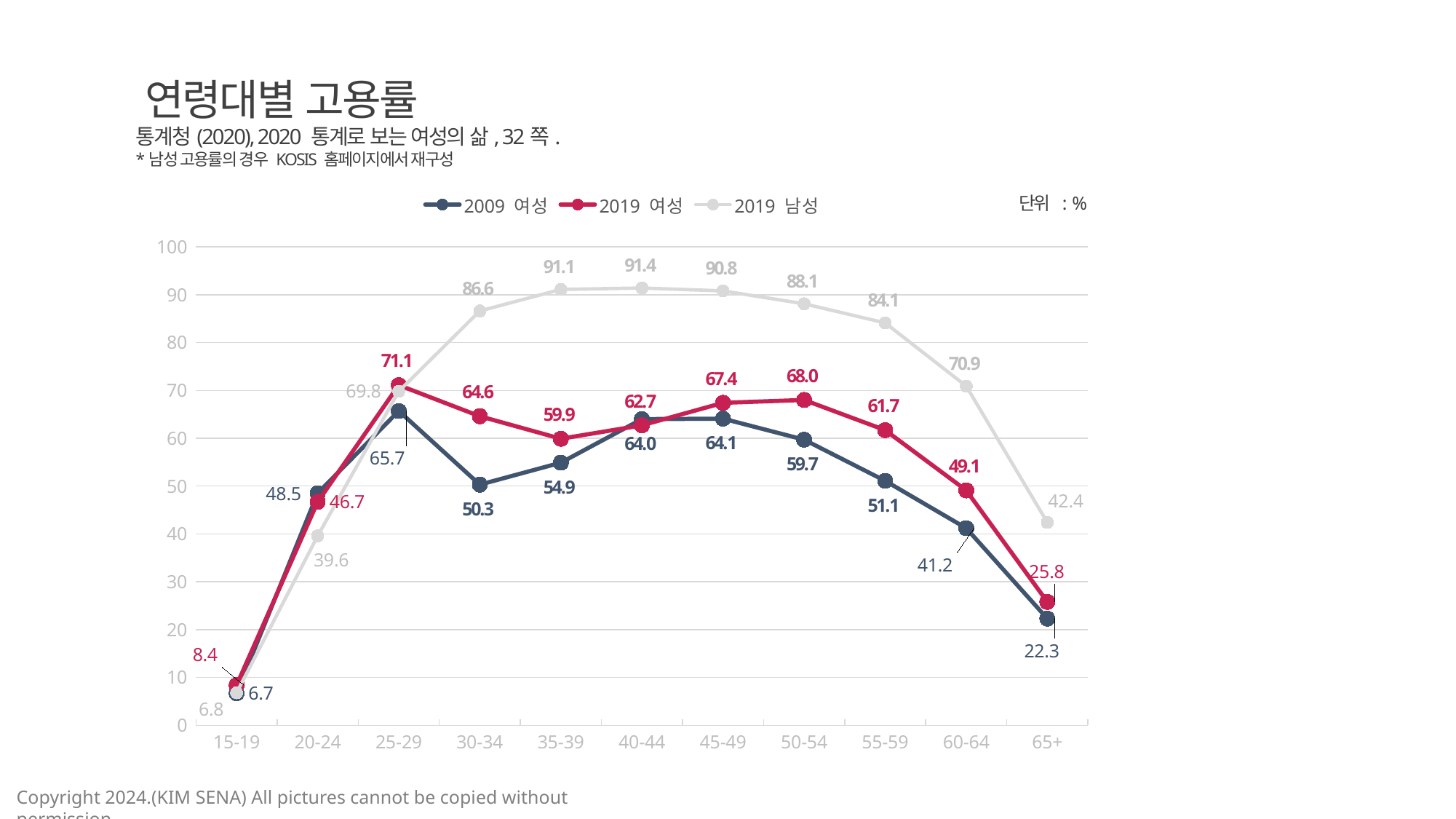
What is the difference between 2019 여성 and 2009 여성 in the 50-54 age group? 8.3 How many series does the legend list? 3 Is the value for 2019 남성 in the 30-34 age group greater or less than 80? greater In which age group is the 2009 여성 series highest? 25-29 Does the 2019 남성 series rise or fall from 50-54 to 65+? fall What is the value for 2009 여성 in the 60-64 age group? 41.2 What kind of chart is this? line chart What is the value for 2019 여성 in the 25-29 age group? 71.1 In the 20-24 age group, which is larger: 2009 여성 or 2019 여성? 2009 여성 How many age groups are shown on the x axis? 11 In which age group is the 2019 남성 series lowest? 15-19 What is the value for 2019 남성 in the 40-44 age group? 91.4